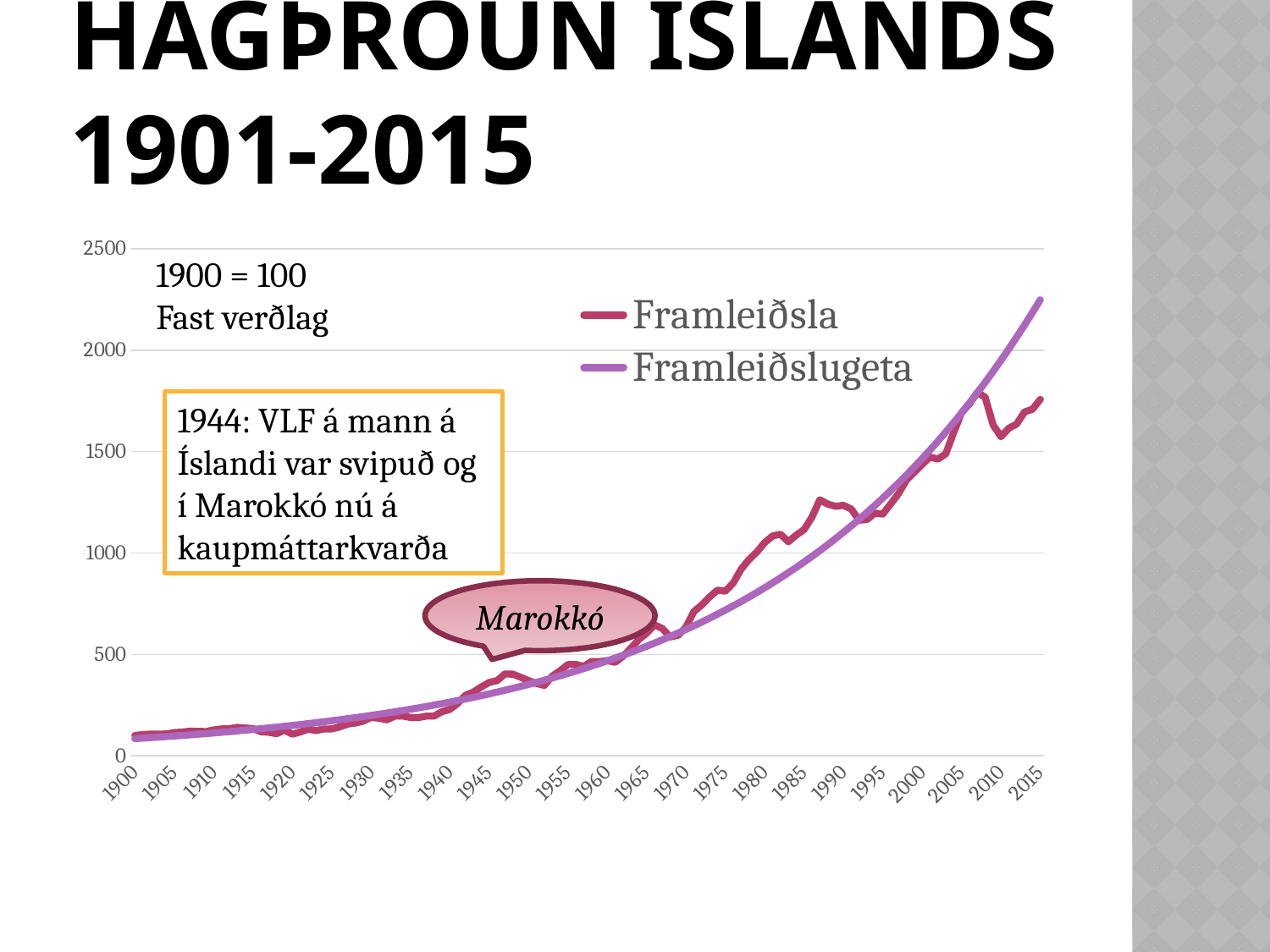
Is the value of Framleiðslugeta in 2015 greater or less than 2000? greater What is the highest value shown on the chart's vertical axis? 2500 Does the Framleiðslugeta line rise or fall from 1900 to 2015? rise In 2015, which series has the higher value, Framleiðsla or Framleiðslugeta? Framleiðslugeta What kind of chart is shown on the slide? line chart How many series does the chart legend list? 2 How many year labels are shown along the x axis? 24 Is the value of Framleiðsla in 2015 greater or less than 2000? less Is the value of Framleiðslugeta in 1980 greater or less than 1000? less What are the two series named in the chart legend? Framleiðsla and Framleiðslugeta In 1985, which series has the higher value, Framleiðsla or Framleiðslugeta? Framleiðsla